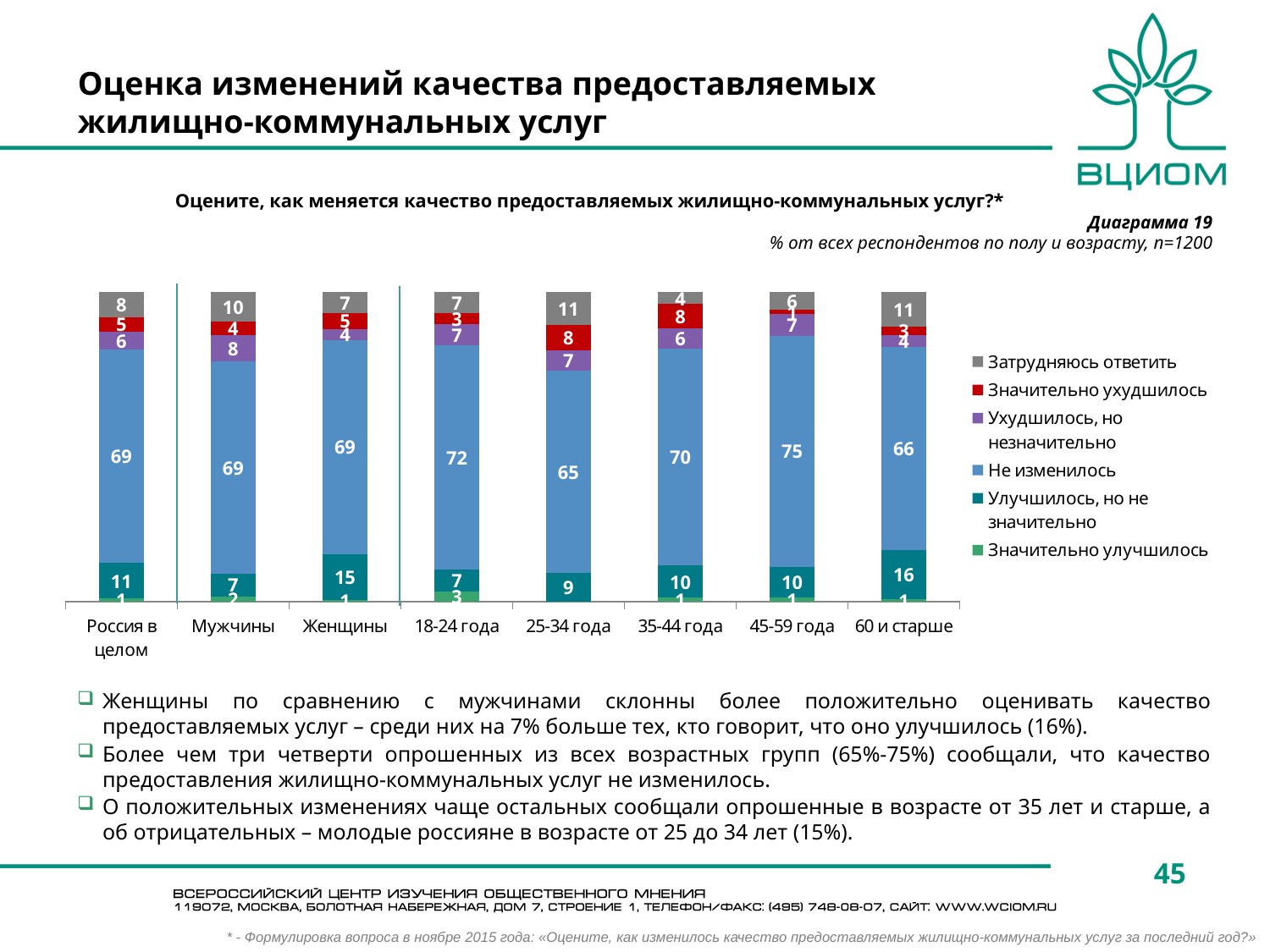
What is the value for "Не изменилось" in the "Россия в целом" category? 69 How many series does the chart legend list? 6 What is the difference between the "Не изменилось" values for "45-59 года" and "25-34 года"? 10 Which category has the highest value for "Не изменилось"? 45-59 года What kind of chart is shown on the slide? Stacked bar chart Which category has the highest value for "Улучшилось, но не значительно"? 60 и старше What is the value for "Затрудняюсь ответить" in the "25-34 года" category? 11 Which category has the lowest value for "Не изменилось"? 25-34 года Which has a larger value for "Улучшилось, но не значительно": "Мужчины" or "Женщины"? Женщины How many categories are shown on the x axis of the chart? 8 What is the value for "Улучшилось, но не значительно" in the "Женщины" category? 15 What is the value for "Не изменилось" in the "45-59 года" category? 75